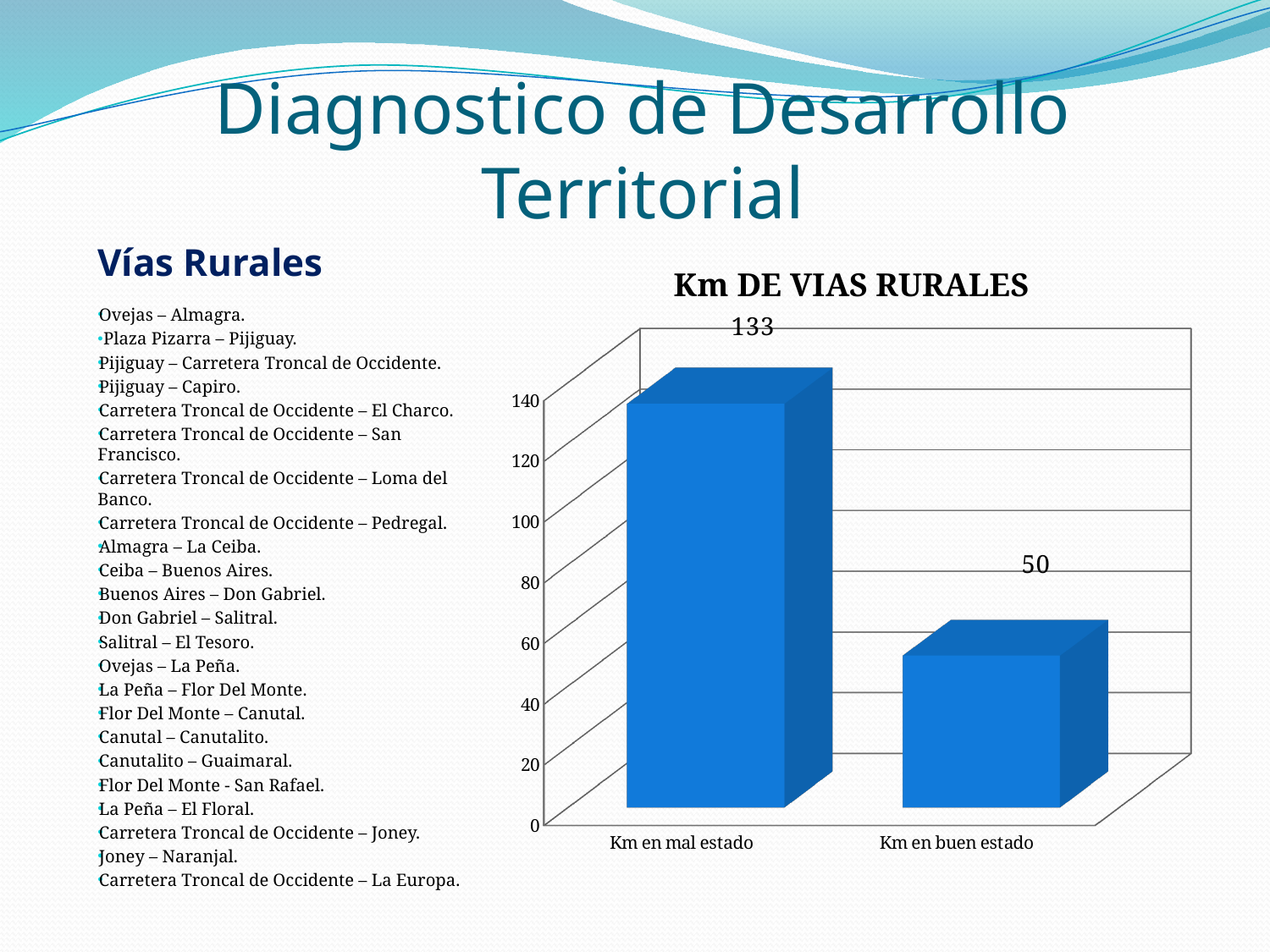
What is the total of the two categories shown in the chart? 183 What is the title of the chart? Km DE VIAS RURALES What kind of chart is shown on the slide? bar chart How many categories are shown in the chart? 2 Is the value for Km en buen estado greater or less than 60? less Which is larger, Km en mal estado or Km en buen estado? Km en mal estado Is the value for Km en mal estado greater or less than 120? greater What is the value for Km en mal estado? 133 Which category has the highest value? Km en mal estado What is the value for Km en buen estado? 50 Which category has the lowest value? Km en buen estado What is the difference between Km en mal estado and Km en buen estado? 83